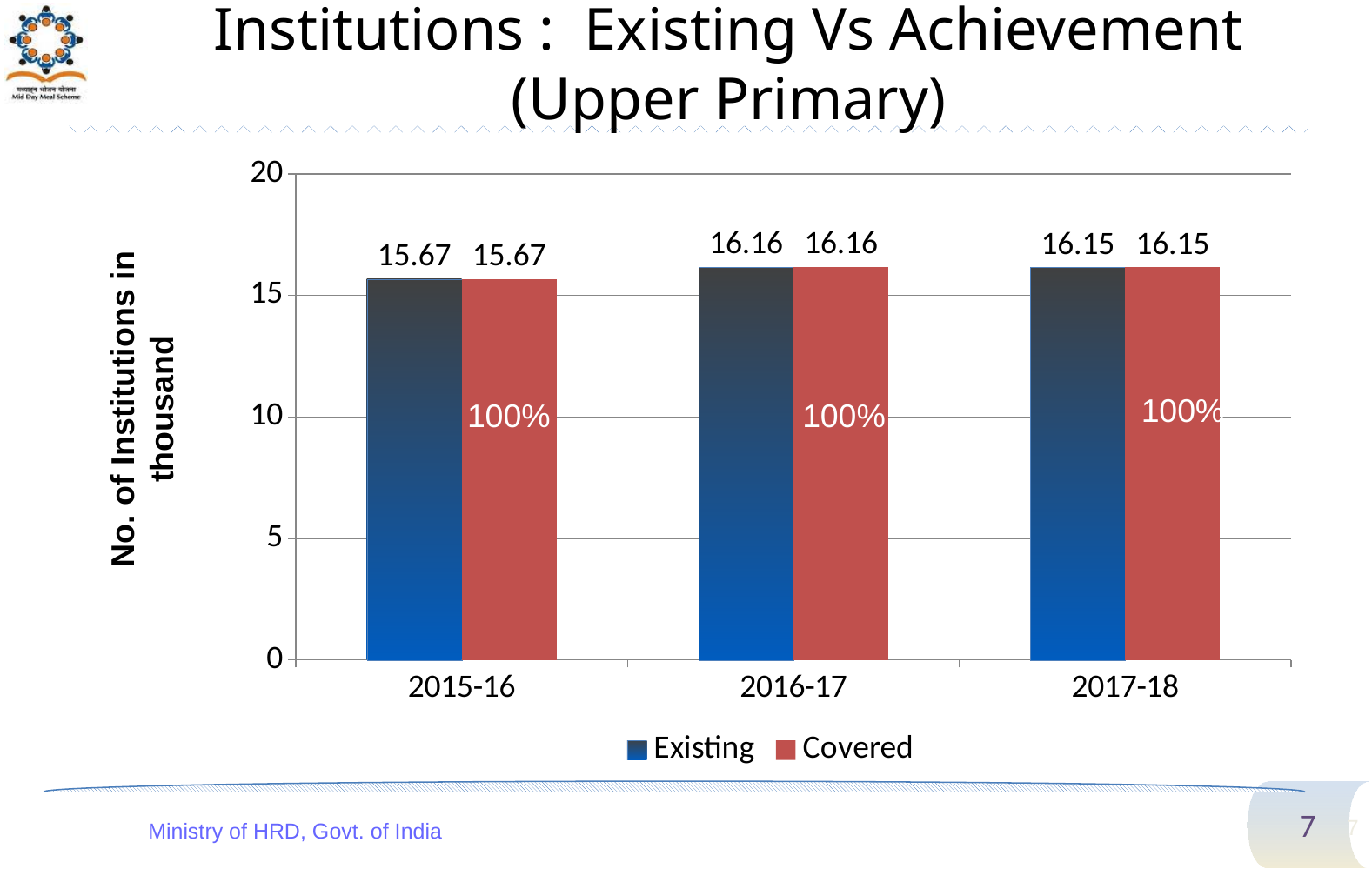
What is the value of Existing institutions for 2017-18? 16.15 What is the value of Covered institutions for 2016-17? 16.16 Which year has the lowest value for Existing institutions? 2015-16 Is the Existing value for 2015-16 larger or smaller than the Existing value for 2016-17? smaller Is the Covered value for 2017-18 greater or less than 15? greater How many series does the legend list? 2 What is the value of Existing institutions for 2015-16? 15.67 What is the y-axis title of the chart? No. of Institutions in thousand What kind of chart is shown on the slide? bar chart What is the difference between the Existing values for 2016-17 and 2015-16? 0.49 What percentage label is shown on each Covered bar? 100% How many years are shown on the x axis? 3